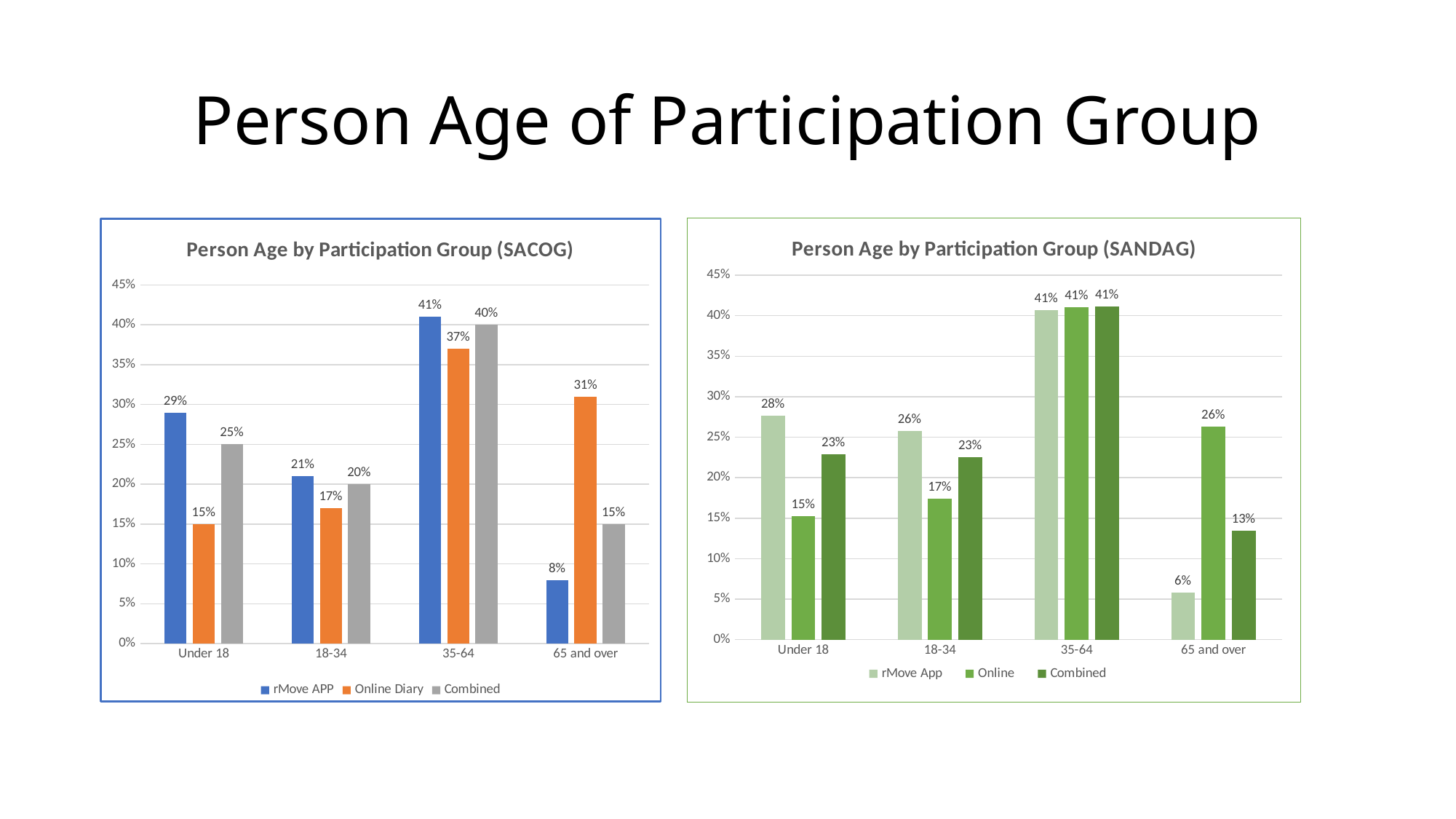
How many series does the legend of the SANDAG chart list? 3 What kind of chart is the SANDAG chart? Bar chart In the SACOG chart, which age group has the highest Online Diary value? 35-64 In the SACOG chart, which series is shown in orange? Online Diary In the SANDAG chart, what is the Online value for the 65 and over age group? 26% In the SANDAG chart, which age group has the lowest rMove App value? 65 and over In the SANDAG chart, what is the difference between the rMove App and Online values for the Under 18 age group? 13% In the SANDAG chart, is the Combined value for the 18-34 age group greater or less than 20%? greater In the SACOG chart, which is larger for the Under 18 age group: rMove APP or Online Diary? rMove APP In the SACOG chart, what is the rMove APP value for the 35-64 age group? 41% In the SACOG chart, what is the difference between the Online Diary and rMove APP values for the 65 and over age group? 23% How many age groups are shown on the x axis of the SACOG chart? 4